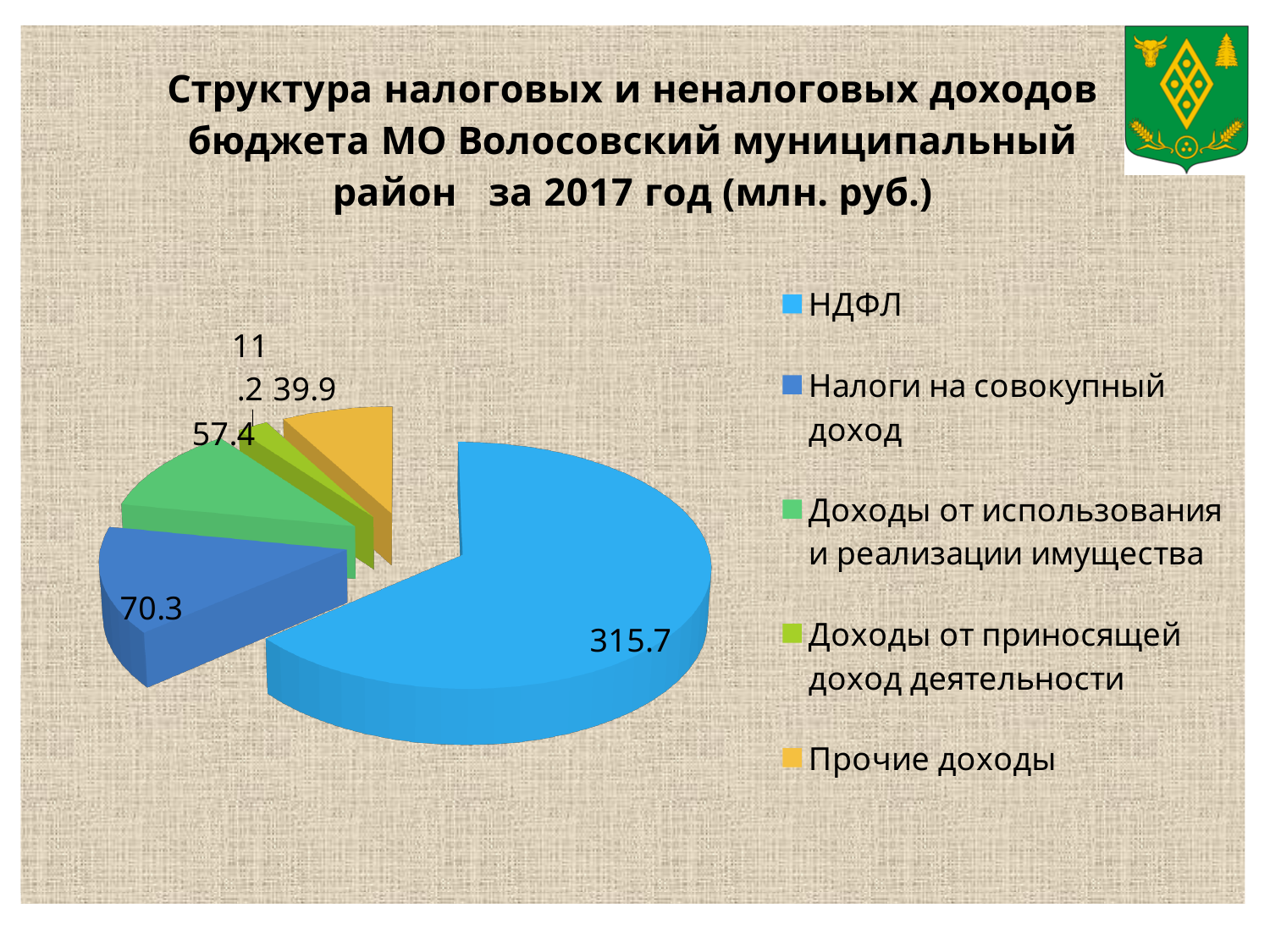
What is the value for Налоги на совокупный доход? 70.3 What is the value for НДФЛ? 315.7 What is the value for Доходы от использования и реализации имущества? 57.4 Which category has the largest slice of the pie? НДФЛ What is the value for Прочие доходы? 39.9 What is the value for Доходы от приносящей доход деятельности? 11.2 Which is larger: Прочие доходы or Доходы от использования и реализации имущества? Доходы от использования и реализации имущества How many categories does the pie chart show? 5 What is the difference between the values for НДФЛ and Налоги на совокупный доход? 245.4 What type of chart is shown on the slide? Pie chart What colour is the slice for Прочие доходы? Yellow Which category has the smallest slice of the pie? Доходы от приносящей доход деятельности